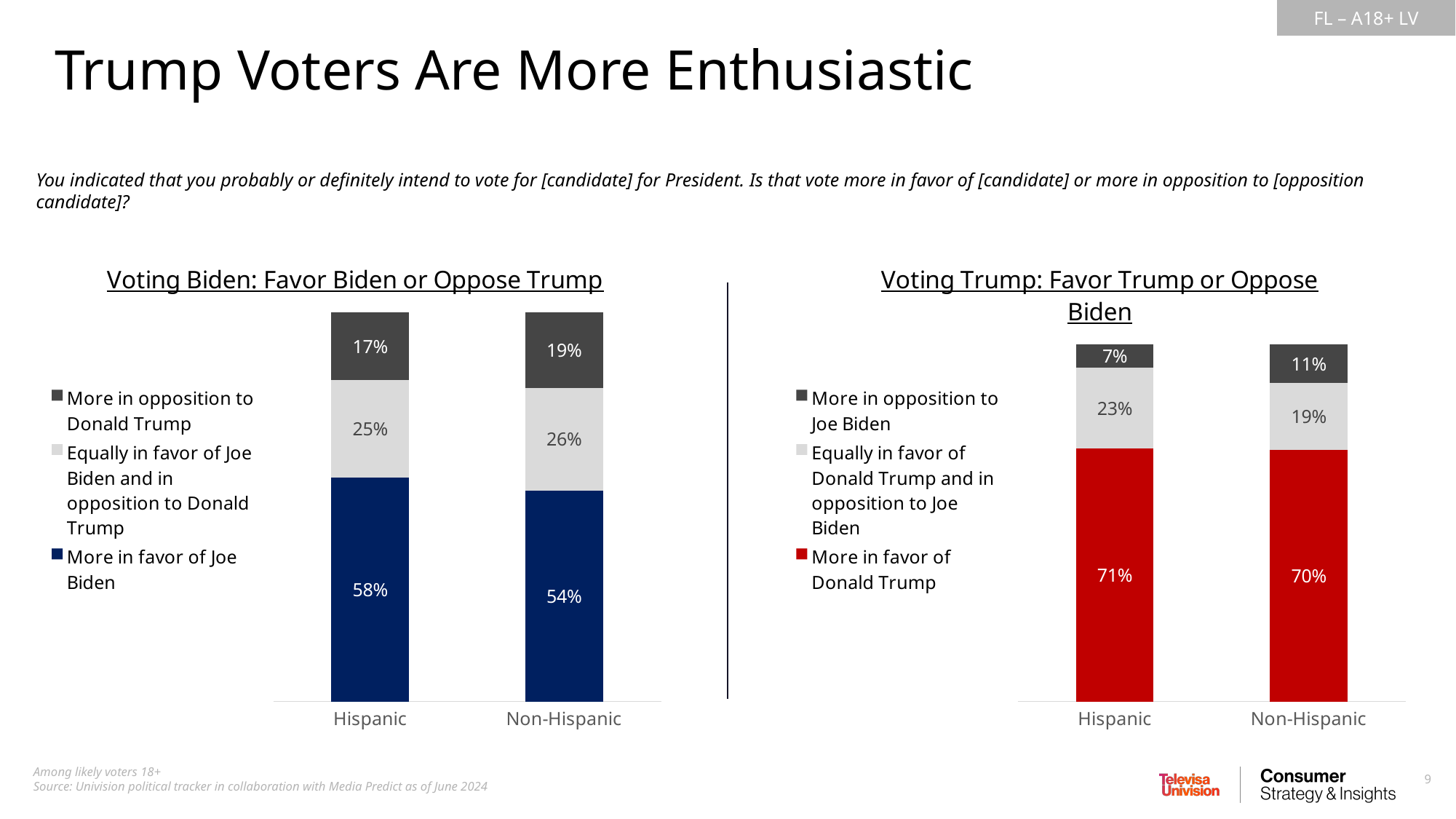
In the 'Voting Biden: Favor Biden or Oppose Trump' chart, what percentage of Non-Hispanic voters are 'More in opposition to Donald Trump'? 19% In the 'Voting Trump: Favor Trump or Oppose Biden' chart, what is the total of the Hispanic stacked bar? 101% What kind of chart is the 'Voting Biden: Favor Biden or Oppose Trump' chart? Stacked bar chart In the 'Voting Trump: Favor Trump or Oppose Biden' chart, what percentage of Hispanic voters are 'More in favor of Donald Trump'? 71% How many categories are shown on the x axis of the 'Voting Biden: Favor Biden or Oppose Trump' chart? 2 In the 'Voting Trump: Favor Trump or Oppose Biden' chart, which group has the higher 'More in opposition to Joe Biden' value, Hispanic or Non-Hispanic? Non-Hispanic In the 'Voting Biden: Favor Biden or Oppose Trump' chart, what percentage of Hispanic voters are 'More in favor of Joe Biden'? 58% In the 'Voting Biden: Favor Biden or Oppose Trump' chart, what is the total of the Non-Hispanic stacked bar? 99% In the 'Voting Trump: Favor Trump or Oppose Biden' chart, what colour represents 'More in favor of Donald Trump'? Red In the 'Voting Biden: Favor Biden or Oppose Trump' chart, what is the difference between the Hispanic and Non-Hispanic 'More in favor of Joe Biden' values? 4 percentage points How many series does the legend of the 'Voting Trump: Favor Trump or Oppose Biden' chart list? 3 In the 'Voting Trump: Favor Trump or Oppose Biden' chart, what percentage of Non-Hispanic voters are 'Equally in favor of Donald Trump and in opposition to Joe Biden'? 19%